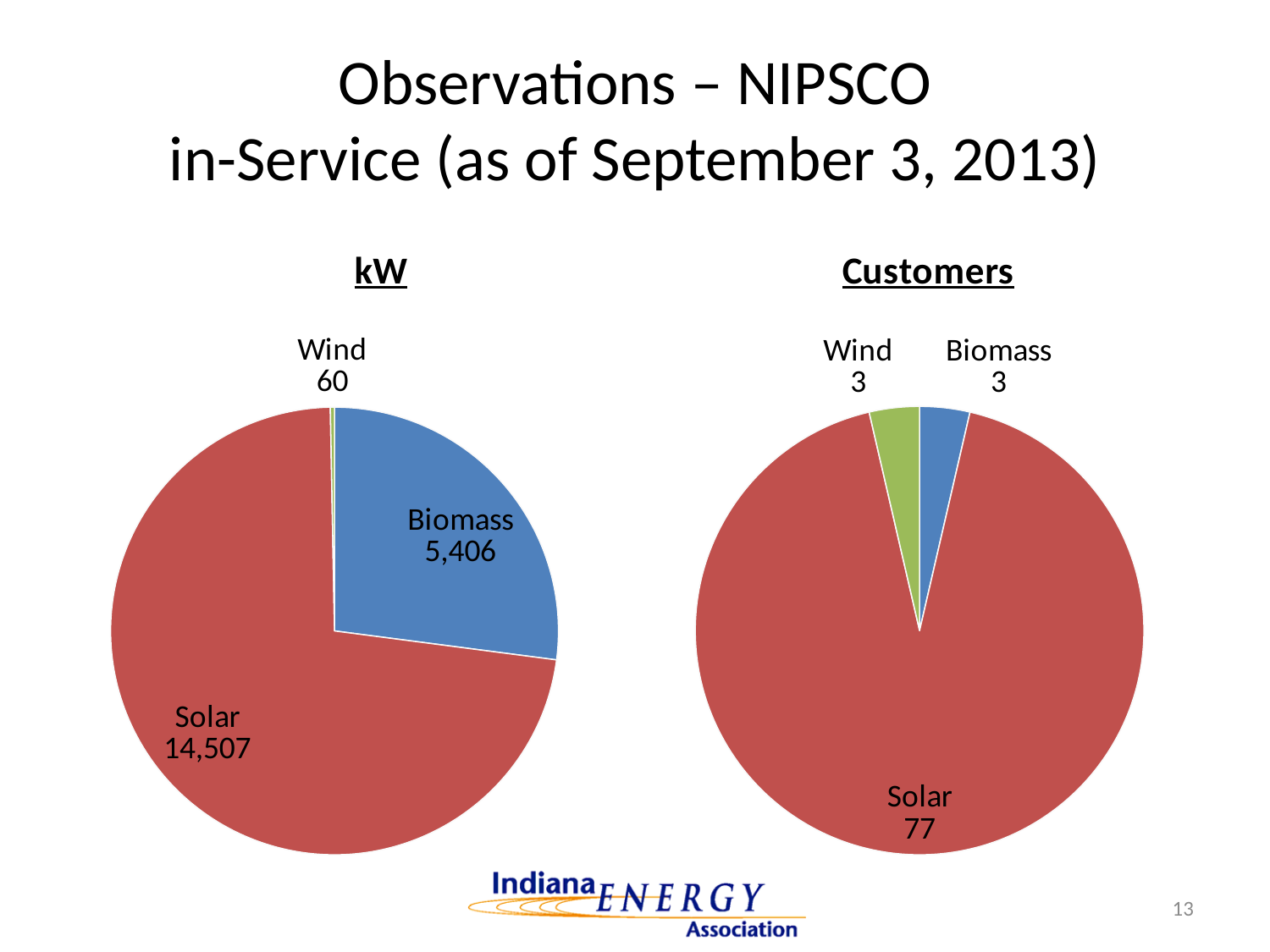
In the kW pie chart, what is the difference between the Solar and Biomass values? 9,101 In the kW pie chart, what is the value for Wind? 60 In the kW pie chart, which category has the largest slice? Solar In the kW pie chart, which is larger, Biomass or Wind? Biomass In the Customers pie chart, what is the difference between the Solar and Biomass customer counts? 74 In the kW pie chart, what is the value for Biomass? 5,406 In the Customers pie chart, how many customers does Wind have? 3 How many categories are shown in the Customers pie chart? 3 In the kW pie chart, which category has the smallest slice? Wind What type of chart is used for the kW data? Pie chart In the kW pie chart, what is the value for Solar? 14,507 In the Customers pie chart, how many customers does Solar have? 77